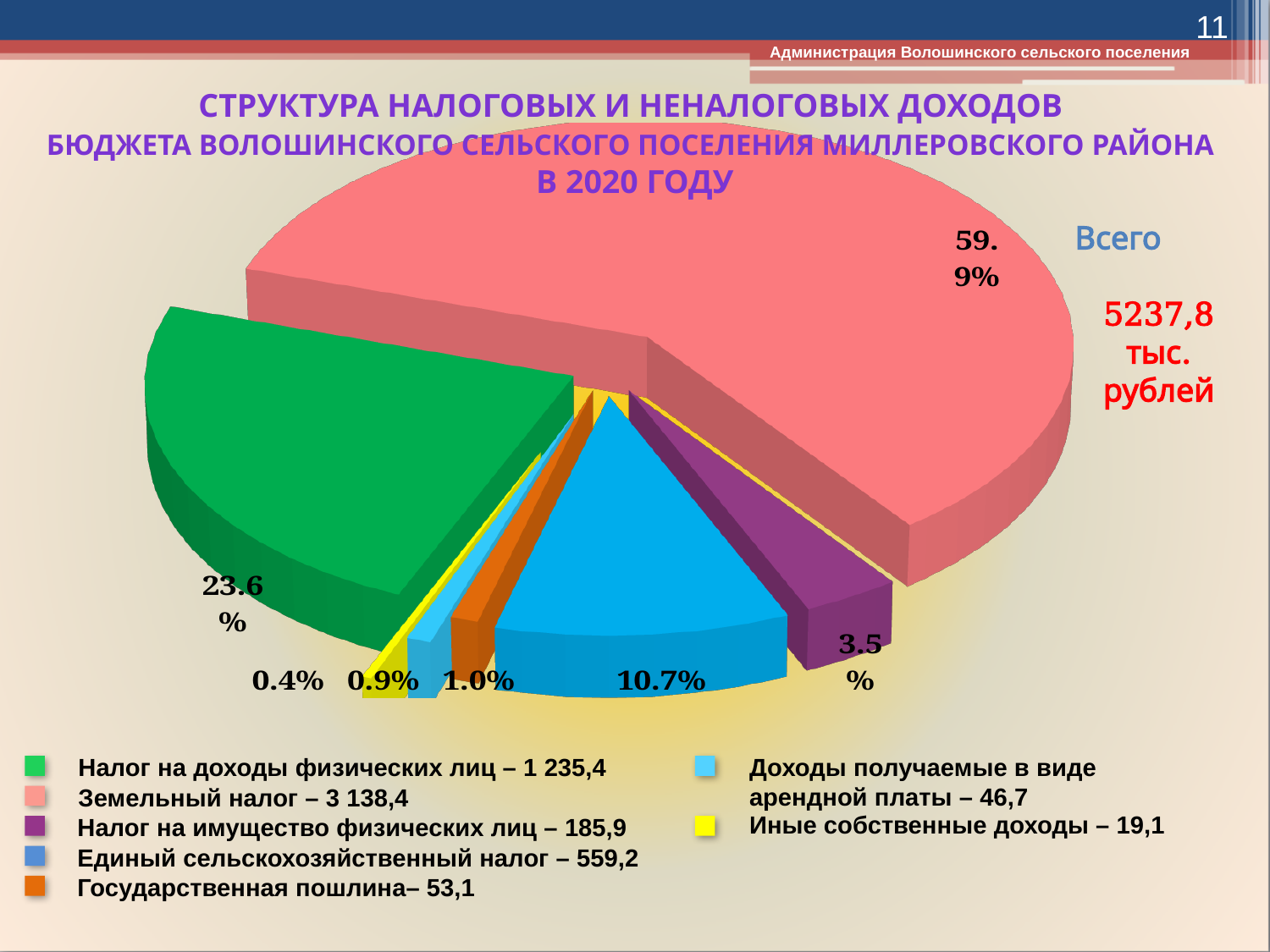
What value is given in the legend for Доходы получаемые в виде арендной платы? 46,7 What total (Всего) is shown next to the pie chart? 5237,8 тыс. рублей What share of the pie does Единый сельскохозяйственный налог take? 10.7% Which category has the largest share of the pie? Земельный налог What is the difference between the legend values for Земельный налог and Налог на доходы физических лиц? 1 903,0 What kind of chart is shown on the slide? pie chart Which category has the smallest share of the pie? Иные собственные доходы Which is larger: Налог на имущество физических лиц or Единый сельскохозяйственный налог? Единый сельскохозяйственный налог What share of the pie does Земельный налог take? 59.9% What value is given in the legend for Государственная пошлина? 53,1 How many slices does the pie chart have? 7 What share of the pie does Налог на доходы физических лиц take? 23.6%